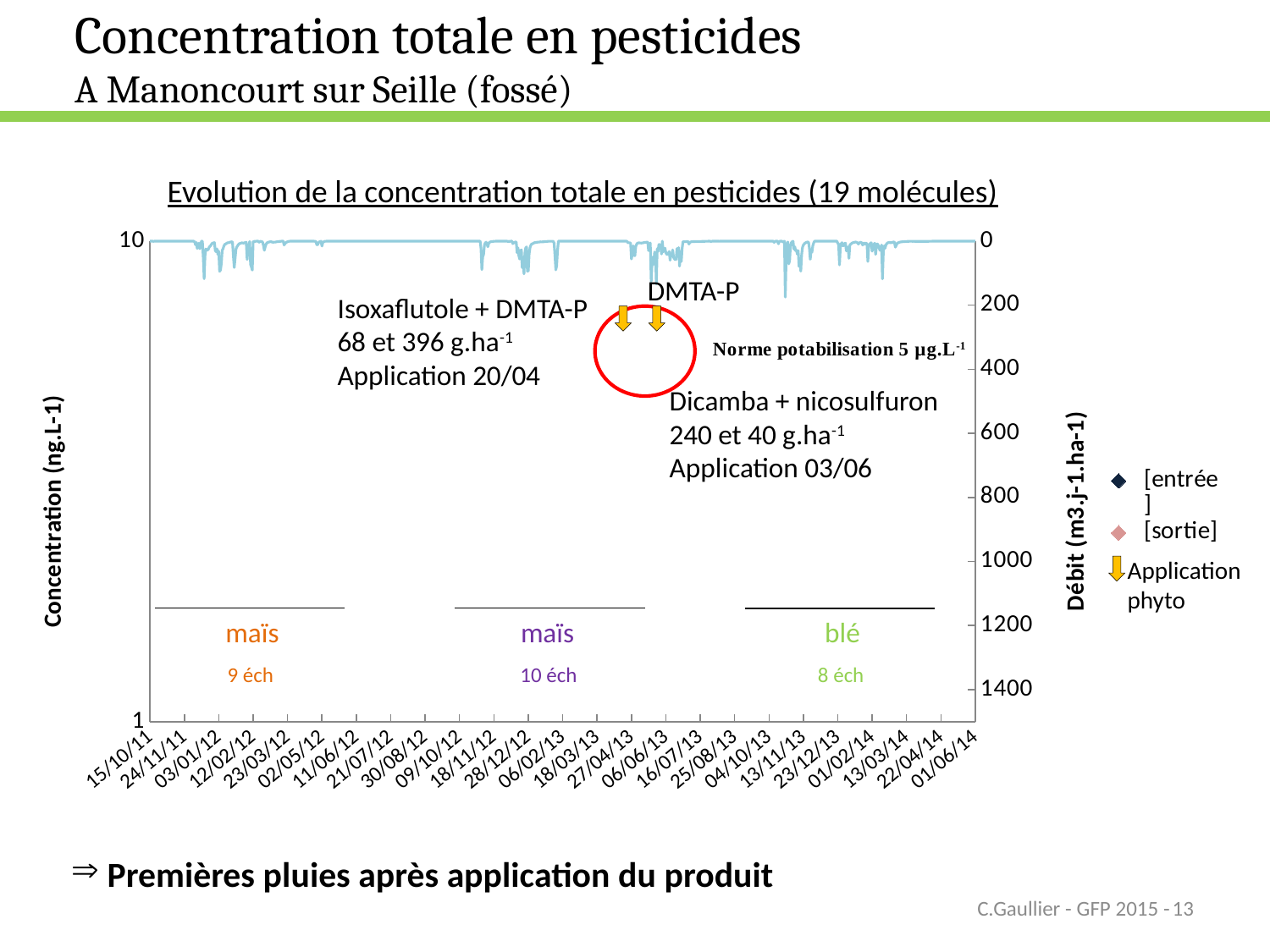
How many samples (éch) are indicated for the second maïs period? 10 éch Which crop period has the highest number of samples (éch)? second maïs period (10 éch) How many samples (éch) are indicated for the blé period? 8 éch Is the débit value at the first date (15/10/11) greater or less than 200? less How many entries does the chart legend list? 2 On what date was the Dicamba + nicosulfuron application made according to the chart annotation? 03/06 What is the label of the left vertical axis? Concentration (ng.L-1) How many crop periods are marked along the bottom of the chart? 3 Which crop period has the lowest number of samples (éch)? blé (8 éch) What is the title of the chart? Evolution de la concentration totale en pesticides (19 molécules) What is the difference in number of samples between the second maïs period and the blé period? 2 What kind of chart is shown on the slide? line chart